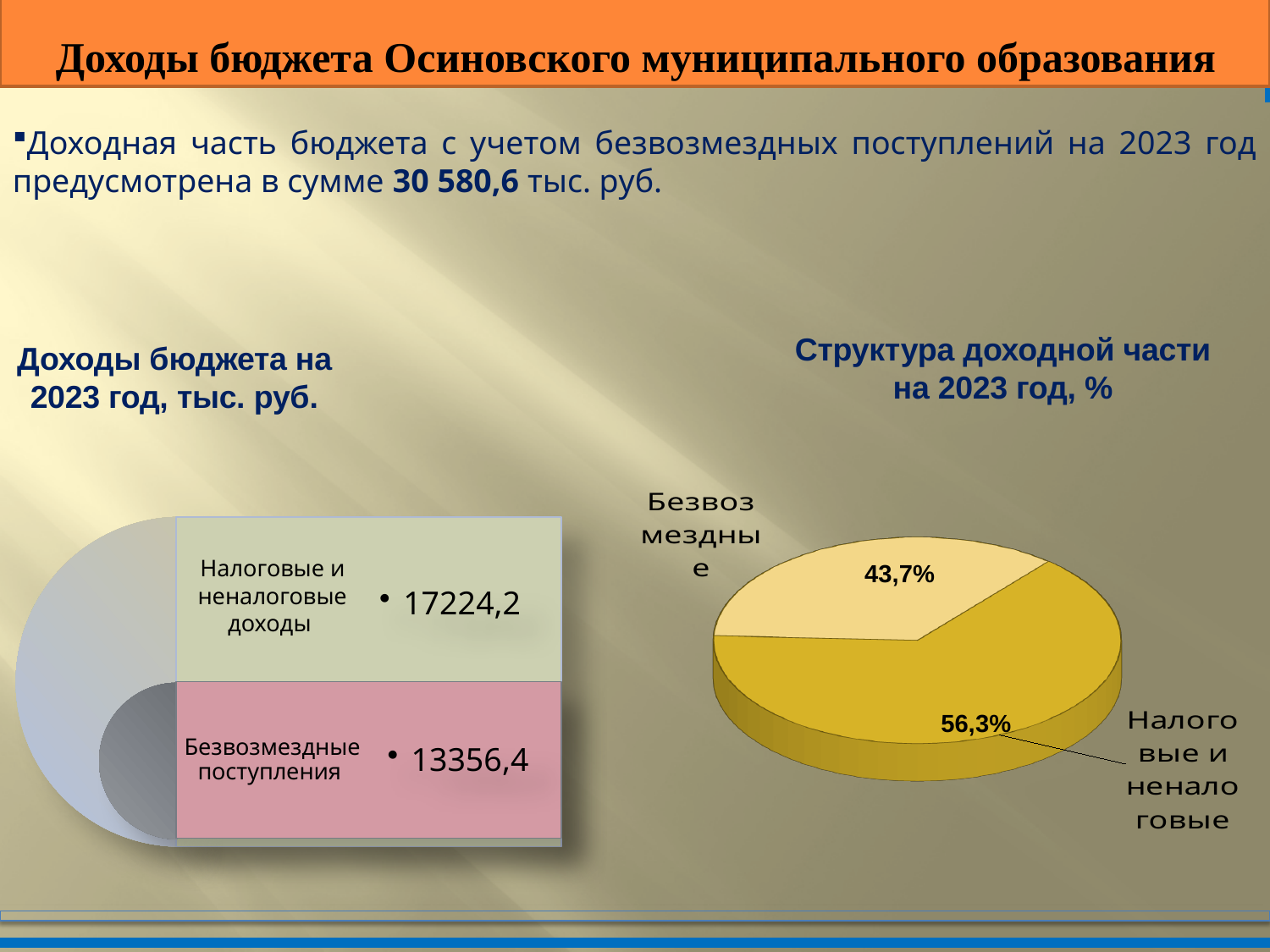
In the pie chart "Структура доходной части на 2023 год, %", which is larger: the "Безвозмездные" slice or the "Налоговые и неналоговые" slice? Налоговые и неналоговые How many slices does the pie chart "Структура доходной части на 2023 год, %" have? 2 What is the title of the pie chart on the right side of the slide? Структура доходной части на 2023 год, % In the pie chart "Структура доходной части на 2023 год, %", what share of the pie does the "Безвозмездные" slice represent? 43,7% In the pie chart "Структура доходной части на 2023 год, %", which slice is the largest? Налоговые и неналоговые In the pie chart "Структура доходной части на 2023 год, %", what share is labelled for the "Безвозмездные" slice? 43,7% What kind of chart is shown under the title "Структура доходной части на 2023 год, %"? pie chart In the pie chart "Структура доходной части на 2023 год, %", what share is labelled for the "Налоговые и неналоговые" slice? 56,3% In the pie chart "Структура доходной части на 2023 год, %", how many percentage points larger is the "Налоговые и неналоговые" slice than the "Безвозмездные" slice? 12,6% In the pie chart "Структура доходной части на 2023 год, %", which slice is the smallest? Безвозмездные